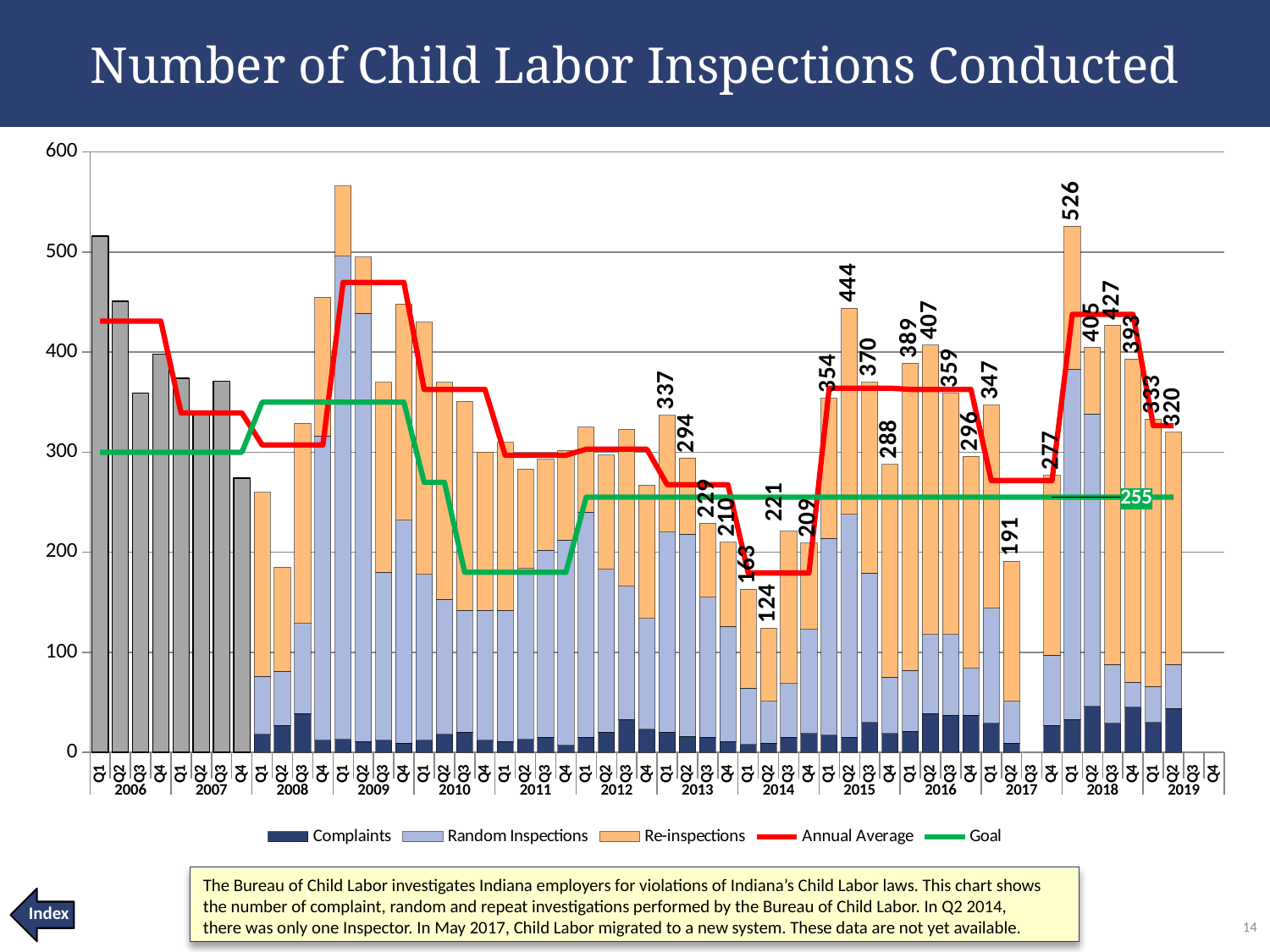
What is the title of the chart? Number of Child Labor Inspections Conducted What is the highest labeled total number of inspections on the chart? 526 What is the lowest labeled total number of inspections on the chart? 124 How many series does the legend list? 5 What is the labeled total for Q2 2017? 191 What value is labeled on the Goal line? 255 What colour is the Annual Average line in the legend? red What is the labeled total for Q4 2017? 277 Is the value for Q1 2006 greater or less than 500? greater What is the difference between the labeled totals for Q1 2018 (526) and Q2 2018 (405)? 121 Which quarter has the larger labeled total, Q2 2015 or Q2 2016? Q2 2015 What kind of chart is used to show the inspection counts? bar chart